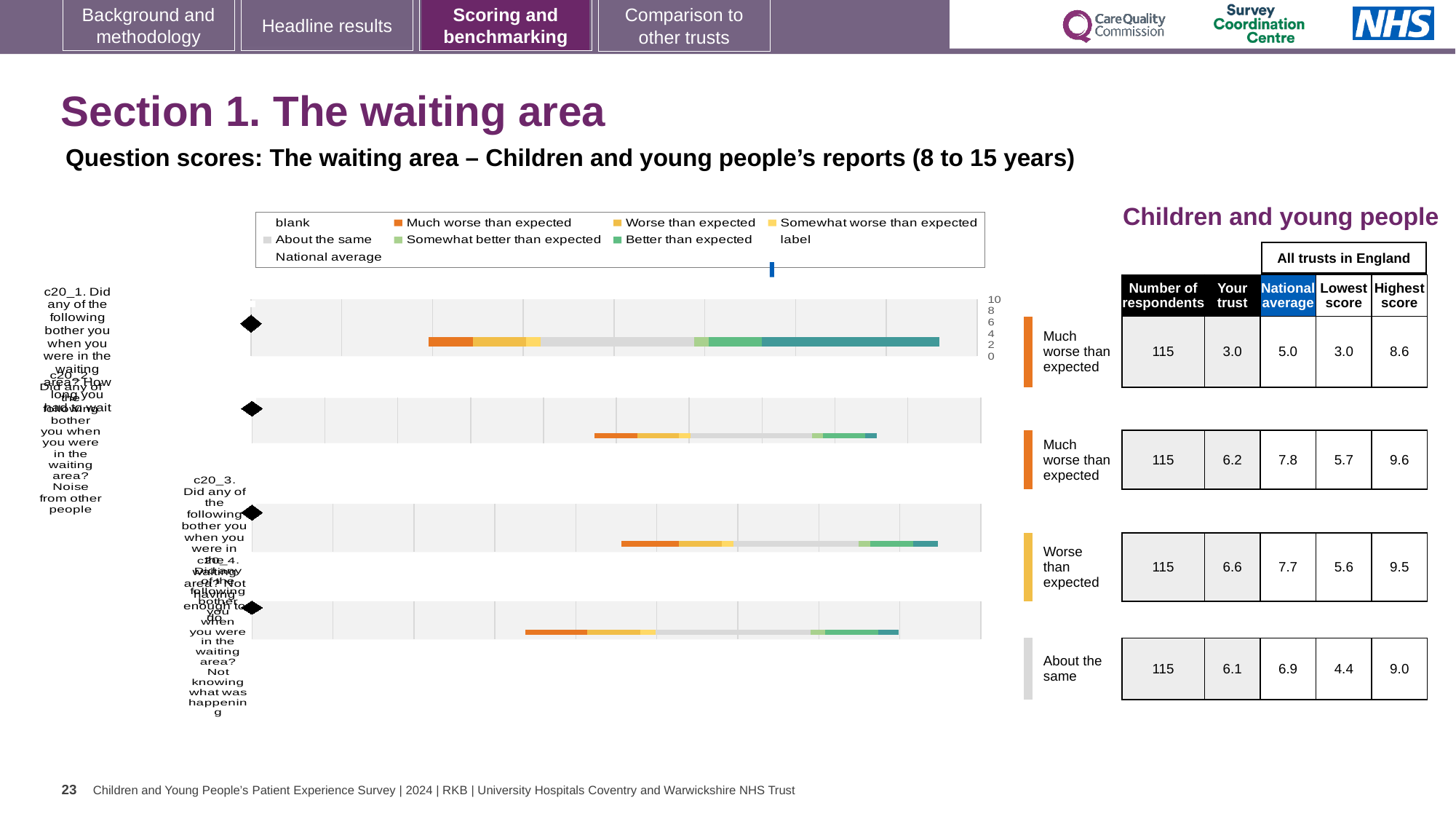
Which question has the highest 'Your trust' score? c20_3 (6.6) What is the 'Your trust' score for the first question, c20_1 (how long you had to wait)? 3.0 What is the national average for the second question, c20_2 (noise from other people)? 7.8 What kind of chart is used to show the question scores for the waiting area? Bar chart Which question has the lowest 'Your trust' score? c20_1 (3.0) How many questions (bars) are plotted in the waiting area chart? 4 What colour represents 'Much worse than expected' in the chart legend? Orange What benchmark rating is given to the third question, c20_3? Worse than expected How many respondents answered each of the waiting area questions? 115 What is the highest score among all trusts in England for question c20_2? 9.6 Which has the larger 'Your trust' score: c20_2 (6.2) or c20_4 (6.1)? c20_2 For question c20_1, how much higher is the national average than the 'Your trust' score? 2.0